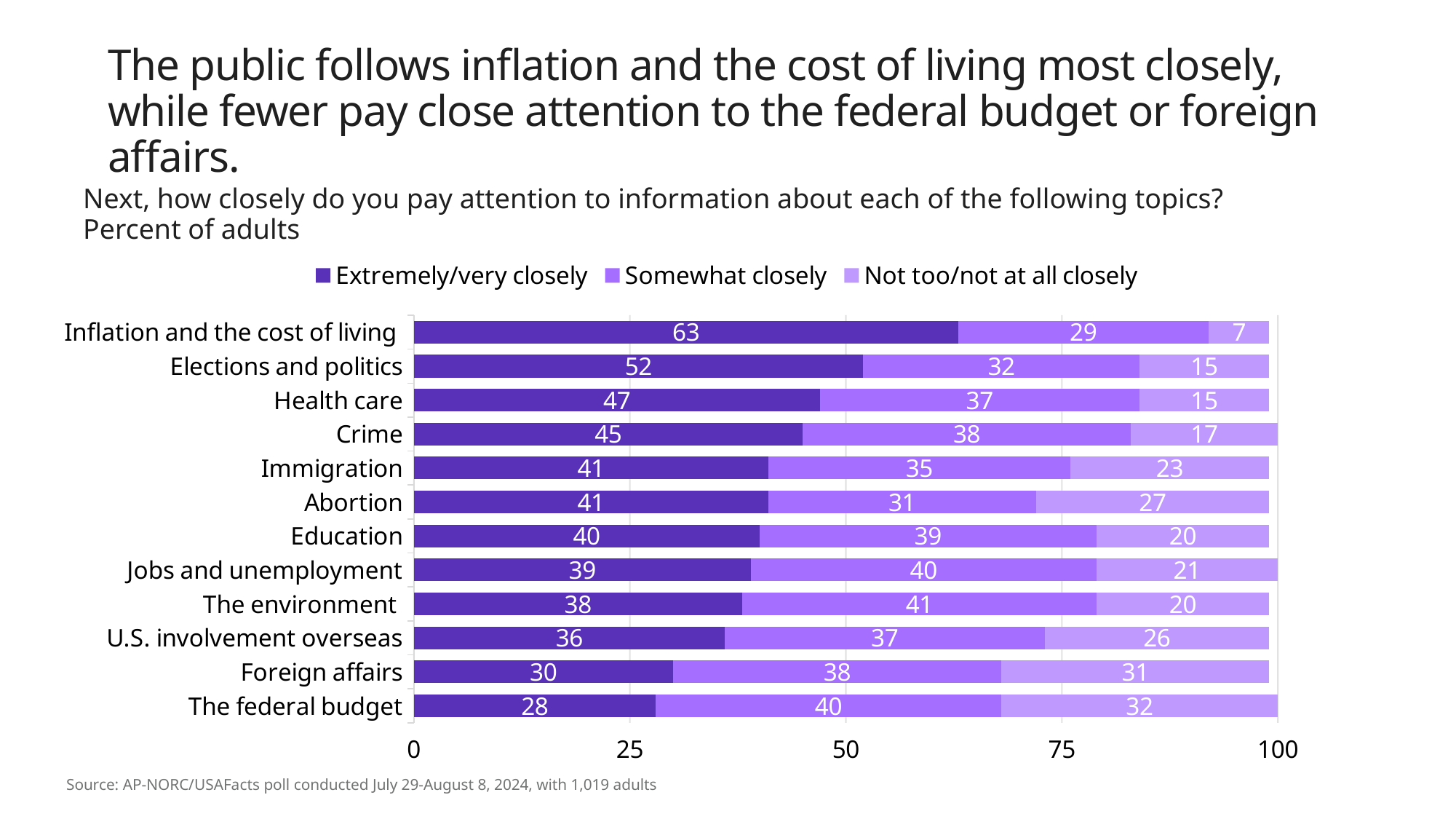
What is the difference between the 'Extremely/very closely' values for Elections and politics and Foreign affairs? 22 Which topic has the lowest 'Extremely/very closely' value? The federal budget How many topics are shown in the chart? 12 What is the total of the stacked bar for Crime? 100 Which topic has the highest 'Extremely/very closely' value? Inflation and the cost of living What is the 'Not too/not at all closely' value for The federal budget? 32 What is the first entry in the legend? Extremely/very closely What kind of chart is shown on the slide? Stacked bar chart Which has a larger 'Not too/not at all closely' value, Abortion or Immigration? Abortion What is the 'Somewhat closely' value for Health care? 37 What percentage of adults follow inflation and the cost of living extremely/very closely? 63 How many series does the legend list? 3